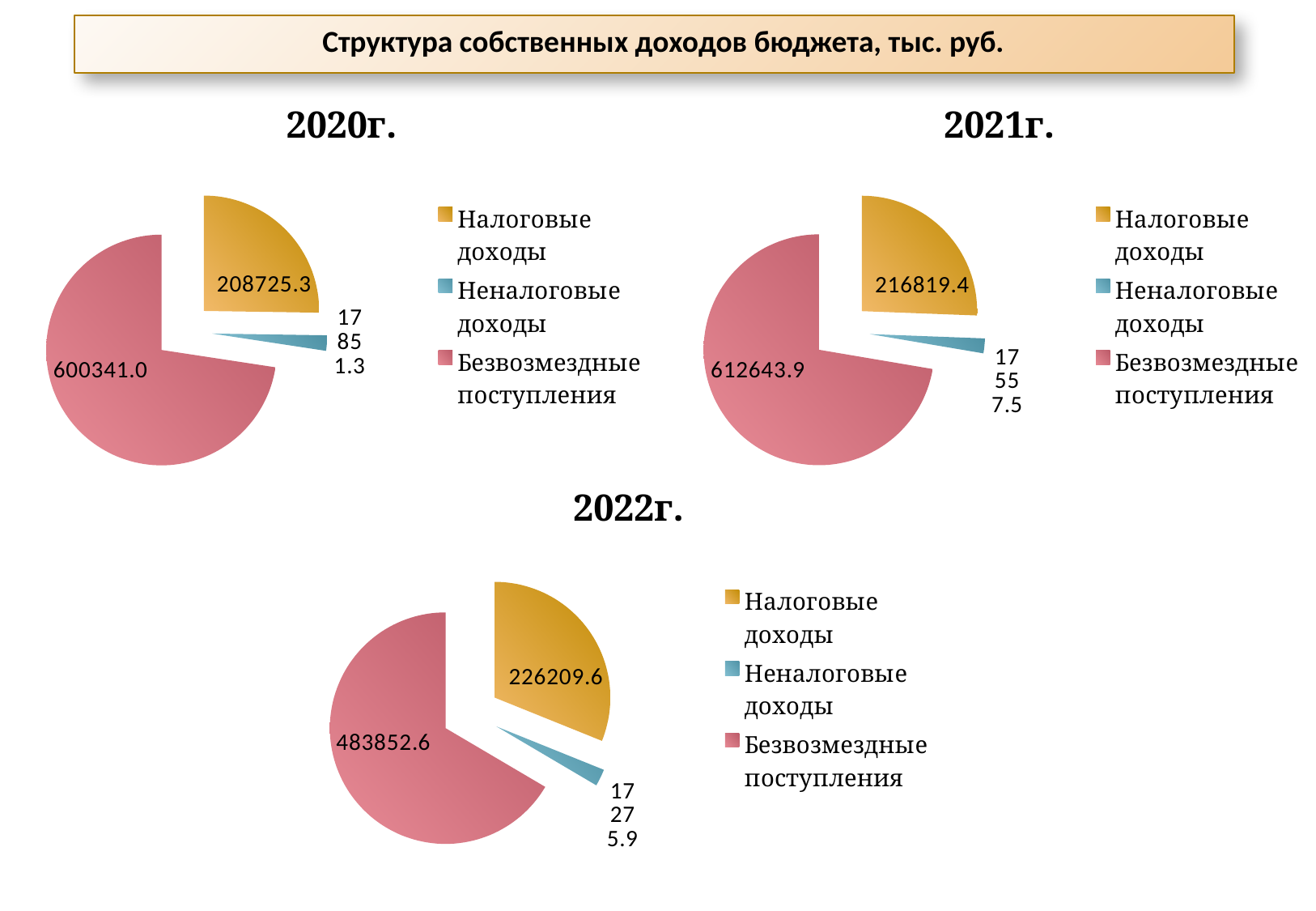
In the 2021г. pie chart, what is the value for Налоговые доходы? 216819.4 In the 2022г. pie chart, which category has the smallest slice? Неналоговые доходы In the 2021г. pie chart, what is the difference between Безвозмездные поступления and Налоговые доходы? 395824.5 In the 2022г. pie chart, what is the value for Налоговые доходы? 226209.6 In the 2021г. pie chart, what is the value for Безвозмездные поступления? 612643.9 What type of chart is used for the 2020г. data? Pie chart In the 2022г. pie chart, what is the value for Безвозмездные поступления? 483852.6 In the 2020г. pie chart, what is the value for Безвозмездные поступления? 600341.0 In the 2022г. pie chart, which is larger: Налоговые доходы or Безвозмездные поступления? Безвозмездные поступления In the 2020г. pie chart, what is the value for Налоговые доходы? 208725.3 In the 2020г. pie chart, which category has the largest slice? Безвозмездные поступления How many categories does the legend of the 2022г. chart list? 3